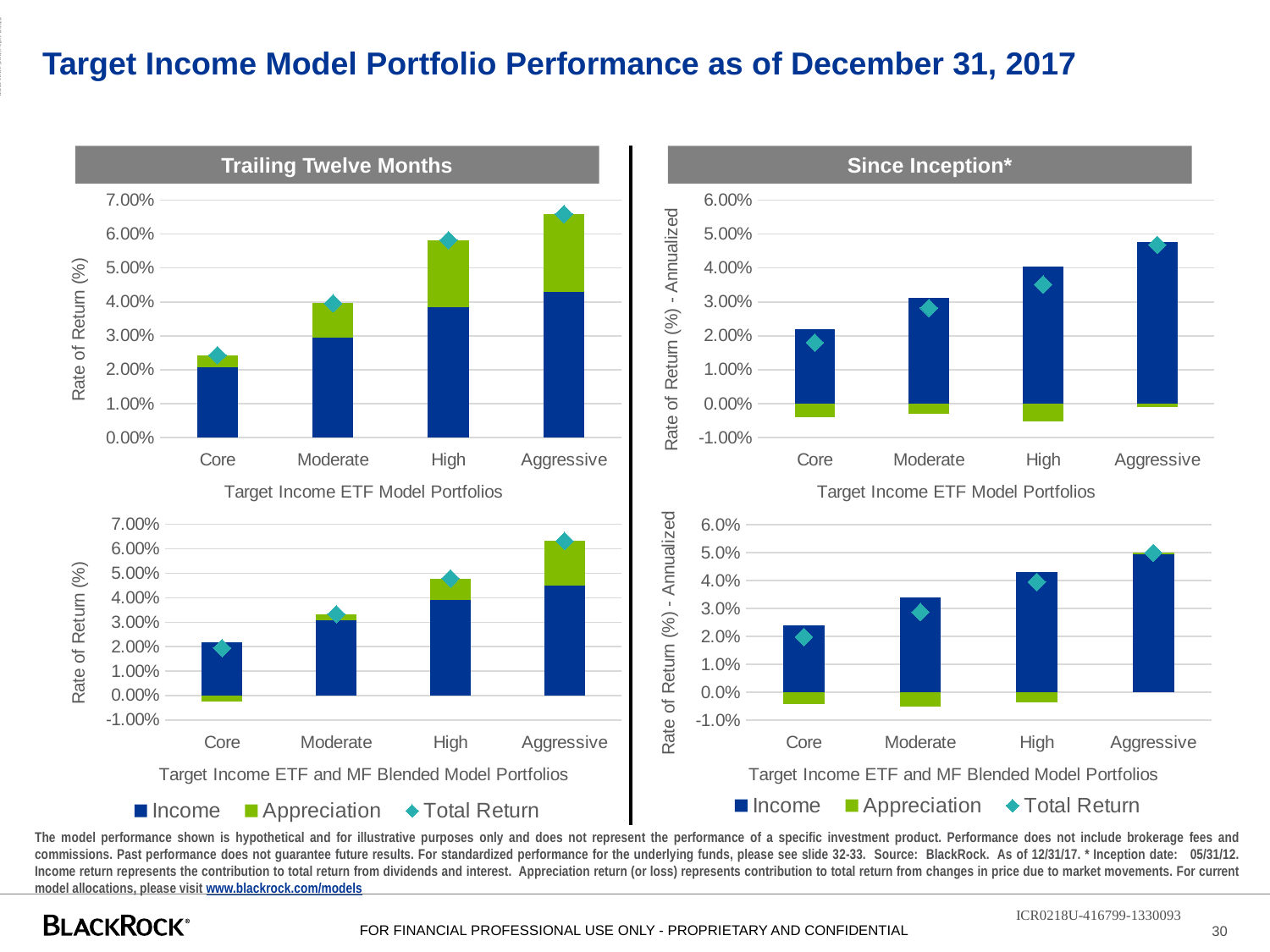
How many portfolio categories are shown on the x axis of the Trailing Twelve Months chart for Target Income ETF Model Portfolios? 4 In the Trailing Twelve Months chart for Target Income ETF Model Portfolios, which portfolio has the highest total return? Aggressive In the Since Inception chart for Target Income ETF Model Portfolios, is the total return for Core greater or less than 3.00%? less In the Since Inception chart for Target Income ETF and MF Blended Model Portfolios, how does total return change moving from Core to Aggressive? It rises In the Since Inception chart for Target Income ETF and MF Blended Model Portfolios, which portfolio has a higher total return, Core or High? High In the Trailing Twelve Months chart for Target Income ETF Model Portfolios, is the total return for Core greater or less than 3.00%? less In the Trailing Twelve Months chart for Target Income ETF Model Portfolios, is the total return for Aggressive greater or less than 6.00%? greater What kind of chart is the Since Inception chart for Target Income ETF Model Portfolios? Bar chart How many series does the legend list for the Trailing Twelve Months charts? 3 In the Trailing Twelve Months chart for Target Income ETF Model Portfolios, which portfolio has the lowest total return? Core